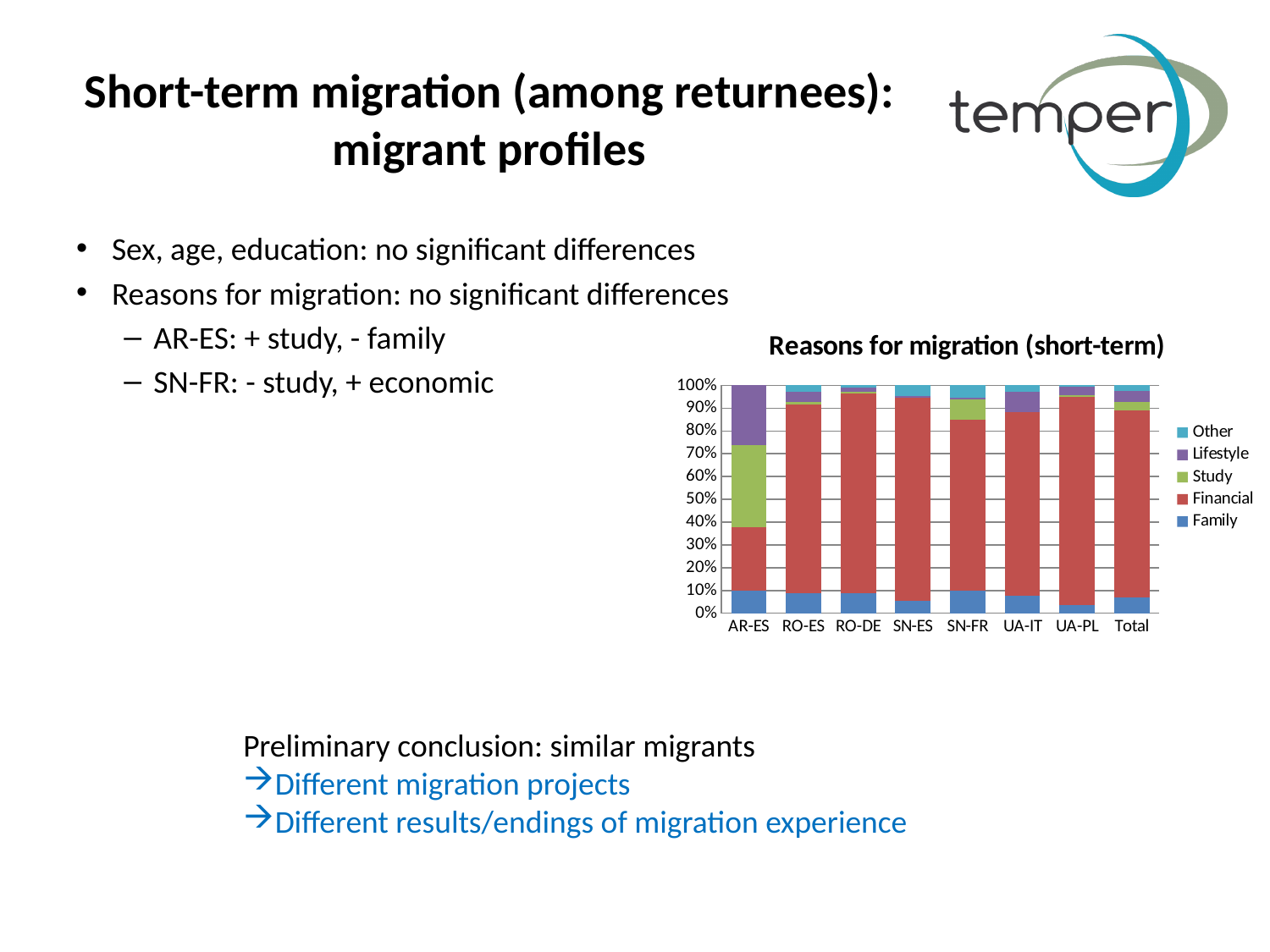
Which has the larger Study share, AR-ES or SN-FR? AR-ES Which series is plotted at the bottom of each stacked bar? Family Is the Study share for AR-ES greater or less than 20%? greater What kind of chart is shown on the slide? Stacked bar chart Is the Financial share for AR-ES greater or less than 50%? less Which category has the largest Study share? AR-ES What is the title of the chart? Reasons for migration (short-term) Is the Family share for AR-ES greater or less than 20%? less How many series does the chart's legend list? 5 How many categories are shown along the x axis of the chart? 8 Which category has the largest Lifestyle share? AR-ES